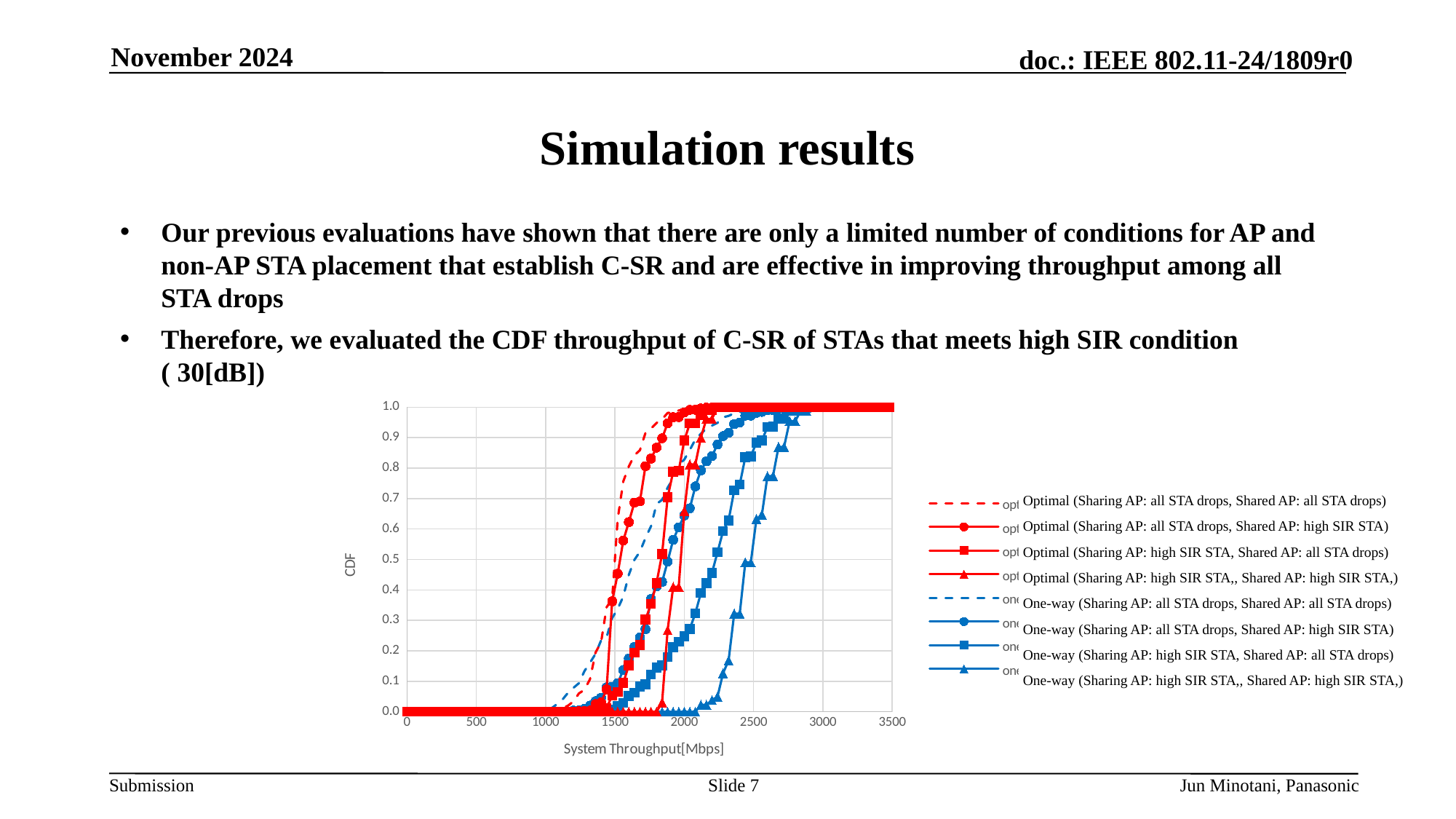
What is the label of the x axis of the chart? System Throughput[Mbps] What is the label of the y axis of the chart? CDF At a system throughput of 2500 Mbps, is the CDF of the Optimal (Sharing AP: high SIR STA,, Shared AP: high SIR STA,) curve greater or less than 0.9? greater At a system throughput of 2000 Mbps, is the CDF of the Optimal (Sharing AP: all STA drops, Shared AP: all STA drops) curve greater or less than 0.5? greater What kind of chart is shown on the slide? Line chart At a system throughput of 2000 Mbps, which curve has the higher CDF: Optimal (Sharing AP: all STA drops, Shared AP: high SIR STA) or One-way (Sharing AP: high SIR STA, Shared AP: all STA drops)? Optimal (Sharing AP: all STA drops, Shared AP: high SIR STA) At a system throughput of 1500 Mbps, is the CDF of the One-way (Sharing AP: high SIR STA, Shared AP: all STA drops) curve greater or less than 0.5? less Do the CDF curves rise or fall as system throughput increases along the x axis? Rise How many series does the chart's legend list? 8 What is the maximum value shown on the x axis of the chart? 3500